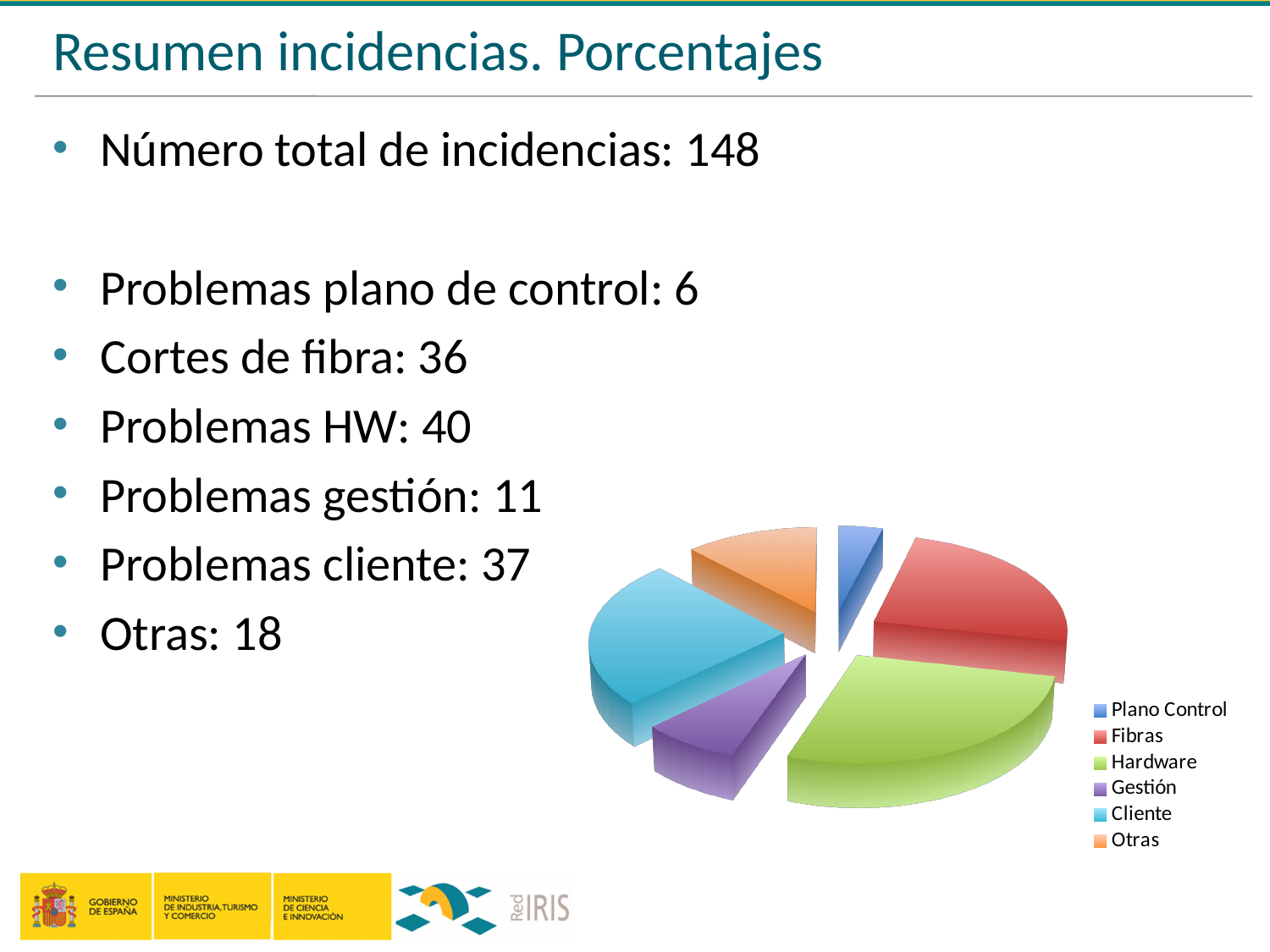
How many entries does the legend of the pie chart list? 6 How many slices does the pie chart have? 6 Which legend entry is shown in red in the pie chart? Fibras What kind of chart is shown on the slide? pie chart Which slice is larger in the pie chart, Cliente or Otras? Cliente Which slice is larger in the pie chart, Cliente or Gestión? Cliente Which slice is larger in the pie chart, Hardware or Gestión? Hardware What colour is the Hardware slice in the pie chart? green Which category has the smallest slice in the pie chart? Plano Control